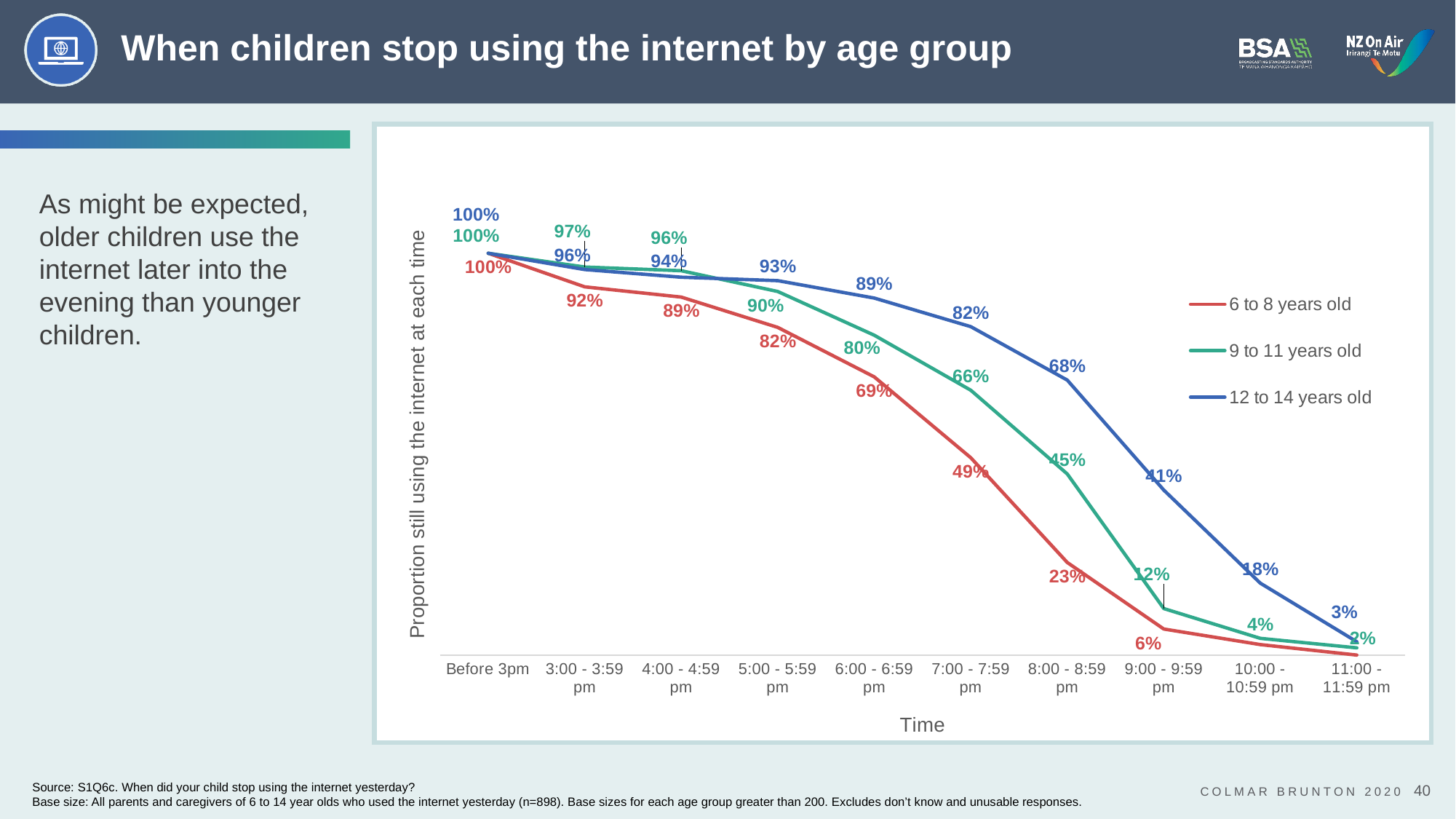
What type of chart is shown on the slide? Line chart Which age group has the highest proportion still using the internet at 9:00 - 9:59 pm? 12 to 14 years old What proportion of 9 to 11 year olds were still using the internet at 9:00 - 9:59 pm? 12% Which age group has the lowest proportion still using the internet at 7:00 - 7:59 pm? 6 to 8 years old Do the values for 9 to 11 year olds rise or fall as time moves from Before 3pm to 11:00 - 11:59 pm? Fall How many age groups does the legend list? 3 At 6:00 - 6:59 pm, which group has the higher proportion still using the internet: 9 to 11 year olds or 6 to 8 year olds? 9 to 11 years old At 8:00 - 8:59 pm, how many percentage points higher is the value for 12 to 14 year olds than for 6 to 8 year olds? 45 percentage points What proportion of 12 to 14 year olds were still using the internet at 10:00 - 10:59 pm? 18% How many time periods are shown on the x axis? 10 What proportion of 6 to 8 year olds were still using the internet at 7:00 - 7:59 pm? 49% What proportion of 12 to 14 year olds were still using the internet at 8:00 - 8:59 pm? 68%